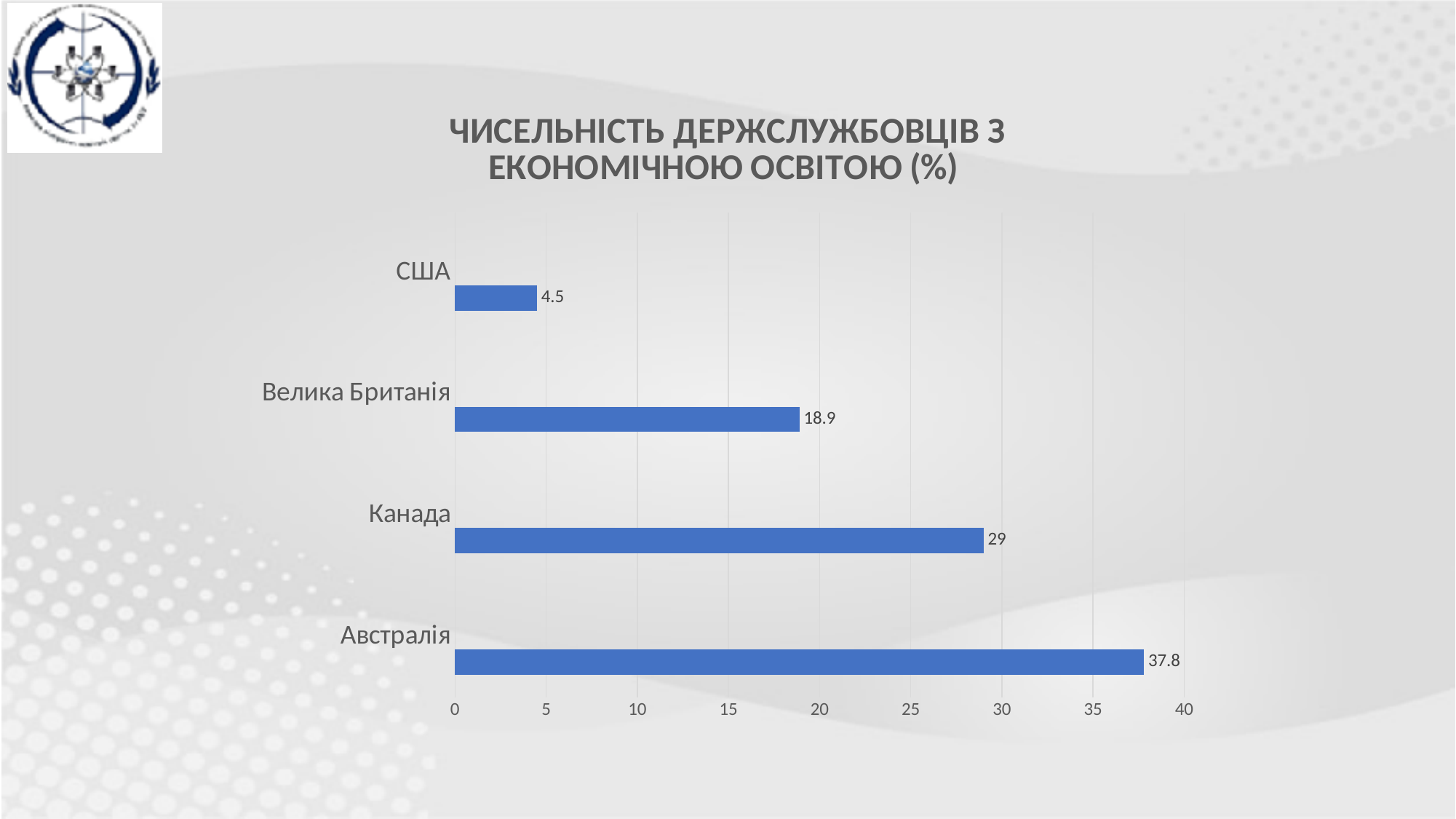
What is the difference between the values for Велика Британія and США? 14.4 How many countries are shown in the chart? 4 What is the difference between the values for Австралія and Канада? 8.8 Which country has the lowest value? США What is the value for Канада? 29 What is the value for Велика Британія? 18.9 What is the title of the chart? ЧИСЕЛЬНІСТЬ ДЕРЖСЛУЖБОВЦІВ З ЕКОНОМІЧНОЮ ОСВІТОЮ (%) Which is larger, the value for Канада or the value for Велика Британія? Канада What kind of chart is shown on the slide? Bar chart What is the value for Австралія? 37.8 Which country has the highest value? Австралія What is the value for США? 4.5